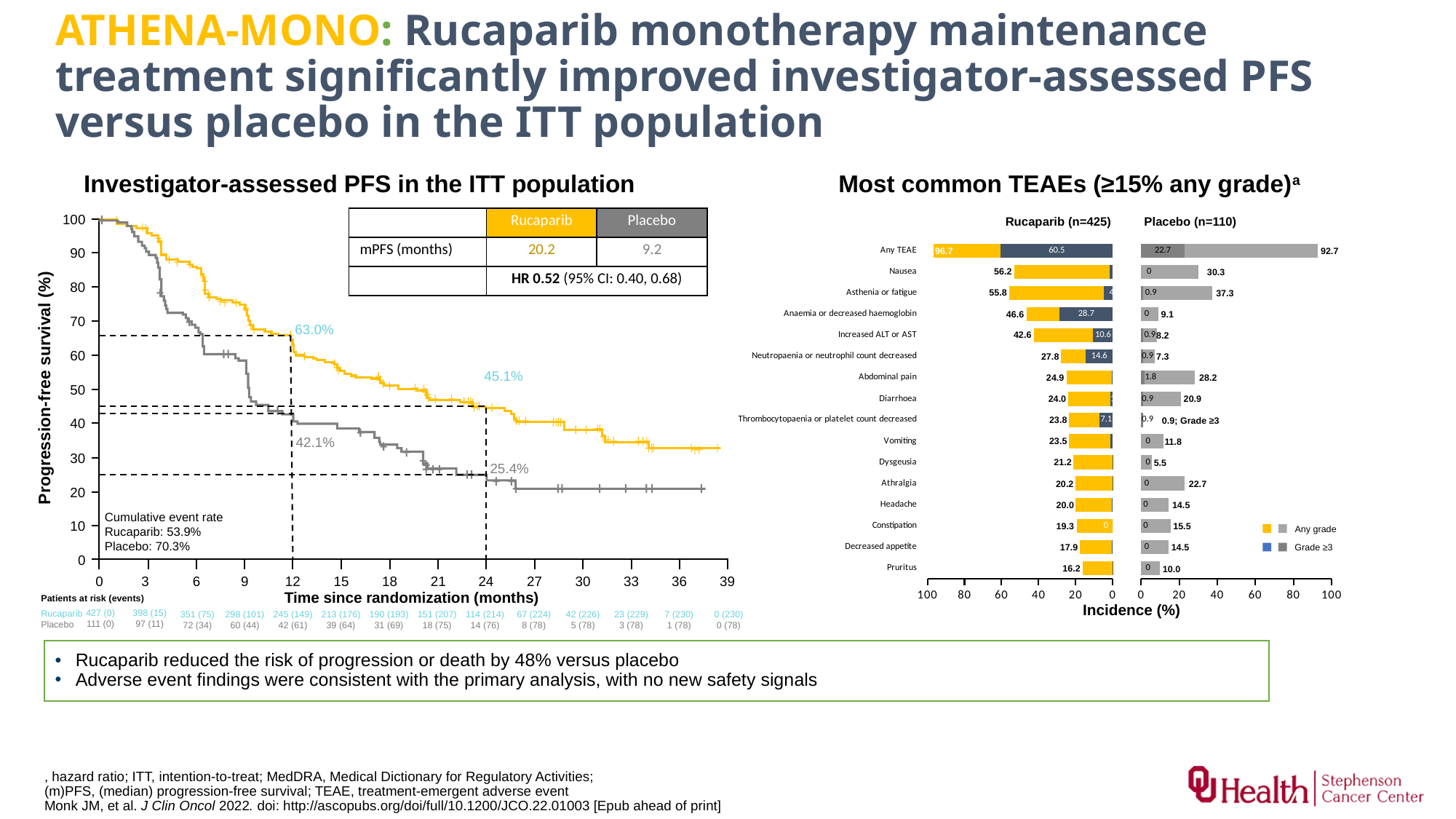
In the 'Most common TEAEs' chart, how many adverse event categories are listed on the y axis? 16 In the 'Investigator-assessed PFS in the ITT population' chart, what hazard ratio is shown? HR 0.52 In the 'Investigator-assessed PFS in the ITT population' chart, what is the median PFS in months for rucaparib? 20.2 In the 'Most common TEAEs' chart, what is the grade ≥3 incidence of anaemia or decreased haemoglobin in the rucaparib arm? 28.7 In the 'Most common TEAEs' chart, how many series does the legend list? 2 In the 'Most common TEAEs' chart, what is the any-grade incidence of nausea in the rucaparib arm? 56.2 In the 'Investigator-assessed PFS in the ITT population' chart, what progression-free survival percentage is labelled for placebo at 24 months? 25.4% In the 'Investigator-assessed PFS in the ITT population' chart, what is the difference between the labelled rucaparib and placebo PFS percentages at 24 months? 19.7% In the 'Most common TEAEs' chart, which adverse event (excluding 'Any TEAE') has the highest any-grade incidence in the placebo arm? Asthenia or fatigue What kind of chart is the 'Most common TEAEs' chart? Bar chart In the 'Investigator-assessed PFS in the ITT population' chart, what is the median PFS in months for placebo? 9.2 In the 'Investigator-assessed PFS in the ITT population' chart, what progression-free survival percentage is labelled for rucaparib at 12 months? 63.0%